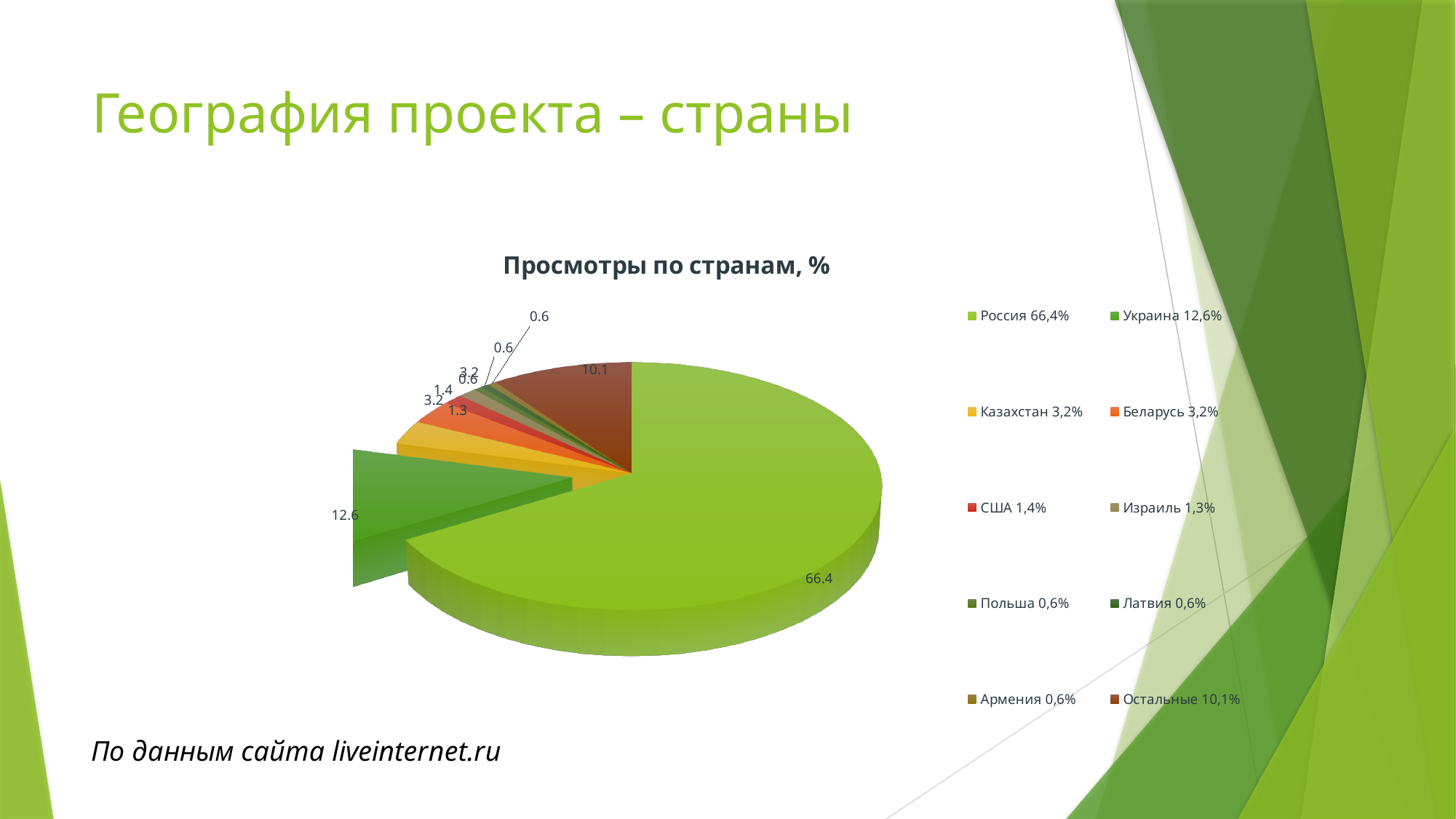
What is the difference between the values for Украина and Остальные? 2.5 Which country has the largest slice of the pie chart? Россия What is the title of the chart? Просмотры по странам, % Which is larger, the value for Казахстан or the value for США? Казахстан What is the value for Россия in the pie chart? 66.4 How many slices does the pie chart have? 10 What is the difference between the values for Россия and Украина? 53.8 What is the value for США in the pie chart? 1.4 What kind of chart is shown on the slide? pie chart What is the value for Остальные in the pie chart? 10.1 What share of the pie does Украина represent? 12.6% What is the value for Украина in the pie chart? 12.6